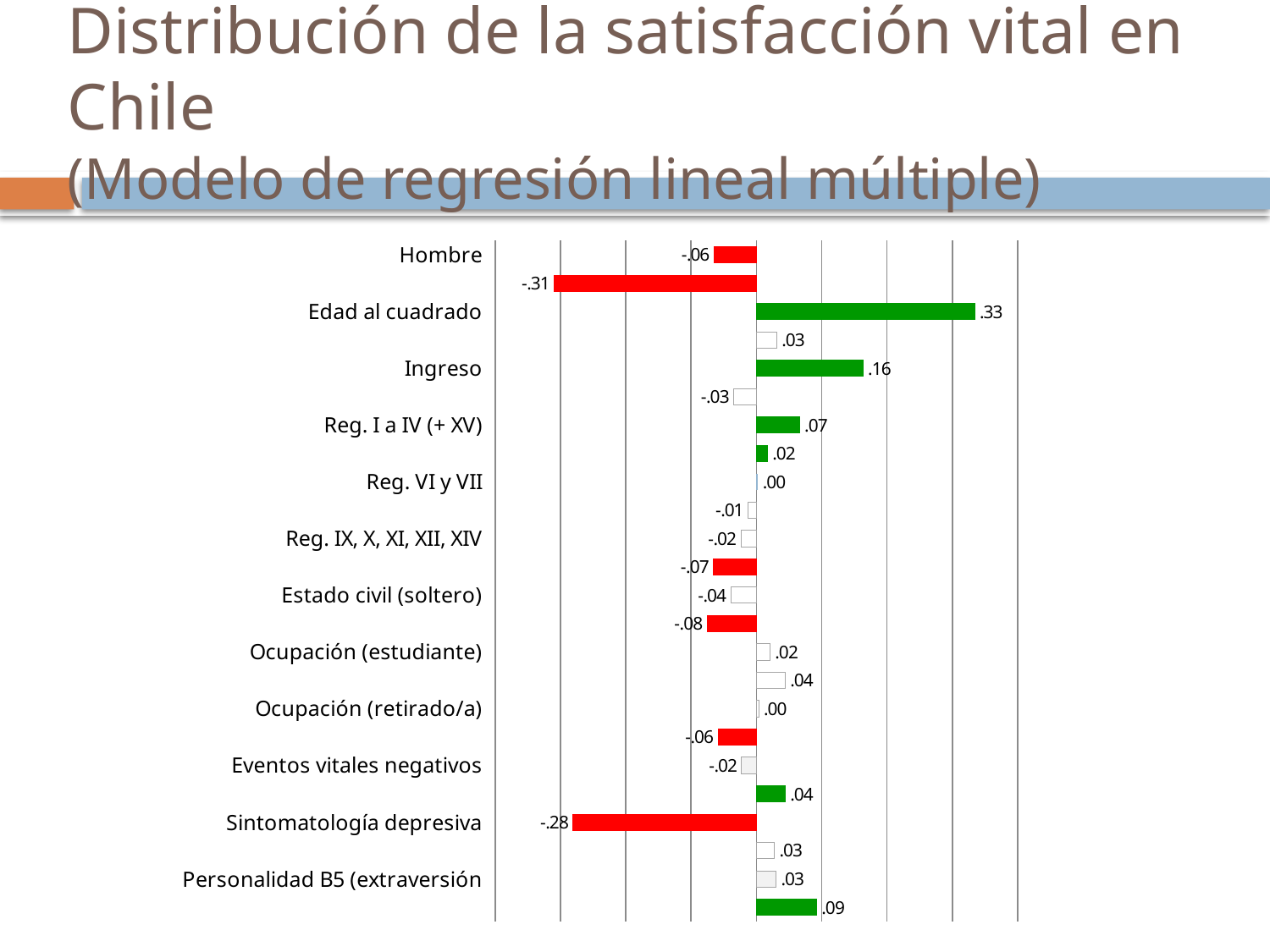
What colour are the bars with large negative values, such as -.31 and -.28? red What is the value shown for Estado civil (soltero)? -.04 What kind of chart is shown on the slide? bar chart What is the value shown for Reg. I a IV (+ XV)? .07 What is the value shown for Hombre? -.06 What is the lowest value printed on any bar in the chart? -.31 What is the difference between the values for Edad al cuadrado and Ingreso? .17 Which labeled category has the highest value in the chart? Edad al cuadrado What is the value shown for Edad al cuadrado? .33 What is the value shown for Ingreso? .16 Which is larger, the value for Edad al cuadrado or the value for Ingreso? Edad al cuadrado What is the value shown for Sintomatología depresiva? -.28